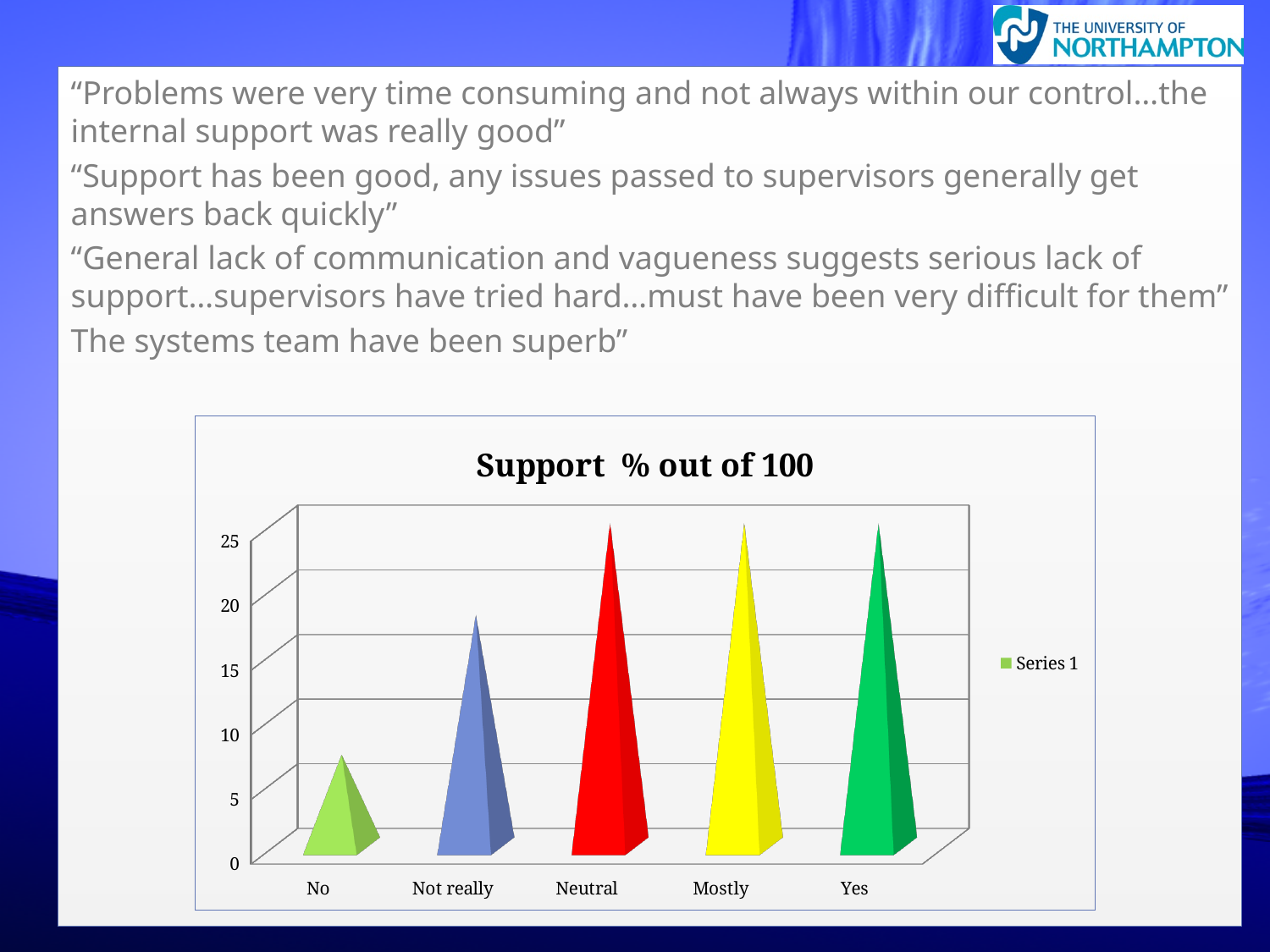
How many categories are shown on the x axis of the chart? 5 How many series does the chart legend list? 1 What is the title of the chart? Support % out of 100 What kind of chart is shown on the slide? bar chart Is the value for Neutral greater or less than 20? greater Do the values rise or fall from No to Neutral along the x axis? rise Which has the larger value, No or Not really? Not really Is the value for Yes greater or less than 20? greater Is the value for No greater or less than 10? less Which category has the lowest value in the chart? No What is the name of the series shown in the legend? Series 1